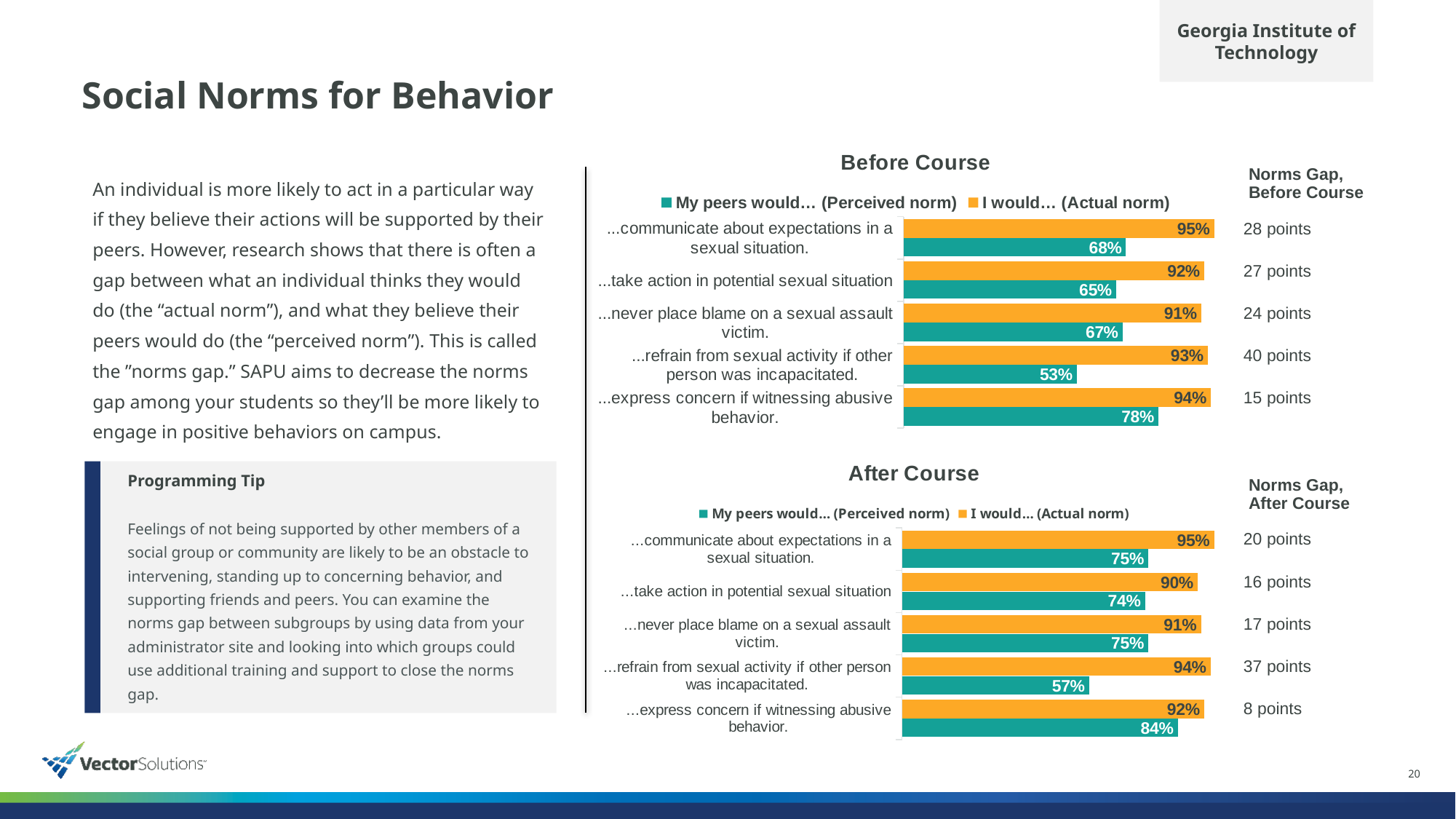
In the Before Course chart, which is larger: the "My peers would… (Perceived norm)" value for "...communicate about expectations in a sexual situation" or for "...take action in potential sexual situation"? ...communicate about expectations in a sexual situation. In the Before Course chart, what is the value for "I would… (Actual norm)" for "...communicate about expectations in a sexual situation"? 95% In the Before Course chart, what is the difference between the "I would… (Actual norm)" and "My peers would… (Perceived norm)" values for "...never place blame on a sexual assault victim"? 24 points In the Before Course chart, which category has the lowest "My peers would… (Perceived norm)" value? ...refrain from sexual activity if other person was incapacitated. In the After Course chart, what is the value for "My peers would… (Perceived norm)" for "...express concern if witnessing abusive behavior"? 84% How many categories are shown in the After Course chart? 5 What type of chart is the Before Course chart? Bar chart In the Before Course chart, what is the value for "My peers would… (Perceived norm)" for "...refrain from sexual activity if other person was incapacitated"? 53% In the After Course chart, what is the value for "I would… (Actual norm)" for "...take action in potential sexual situation"? 90% In the After Course chart, what is the difference between the "I would… (Actual norm)" and "My peers would… (Perceived norm)" values for "...refrain from sexual activity if other person was incapacitated"? 37 points How many series does the legend of the Before Course chart list? 2 In the After Course chart, which category has the highest "My peers would… (Perceived norm)" value? ...express concern if witnessing abusive behavior.